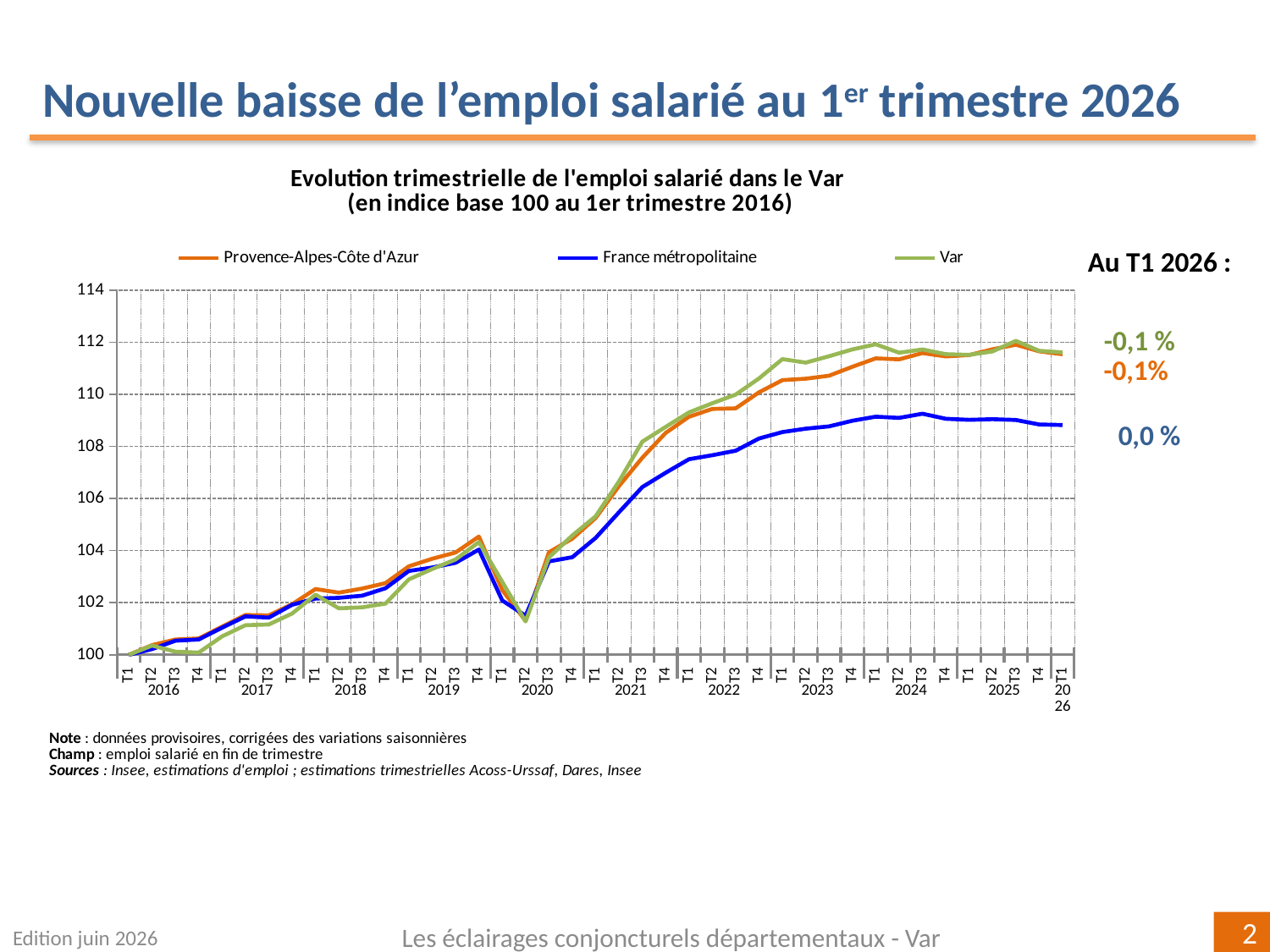
According to the annotation, what is the quarterly change for Var at T1 2026? -0,1 % At T1 2026, which is higher: the Var index or the France métropolitaine index? Var What is the title of the chart? Evolution trimestrielle de l'emploi salarié dans le Var (en indice base 100 au 1er trimestre 2016) At T1 2026, is the index for France métropolitaine greater or less than 110? less How many series does the legend list? 3 What kind of chart is shown on the slide? line chart At T1 2026, is the index for Var greater or less than 110? greater According to the annotation, what is the quarterly change for Provence-Alpes-Côte d'Azur at T1 2026? -0,1% Which series has the lowest index value at T1 2026? France métropolitaine Which colour is used for the France métropolitaine line? blue According to the annotation, what is the quarterly change for France métropolitaine at T1 2026? 0,0 % Overall, does the Var index rise or fall between T1 2016 and T1 2025? rise